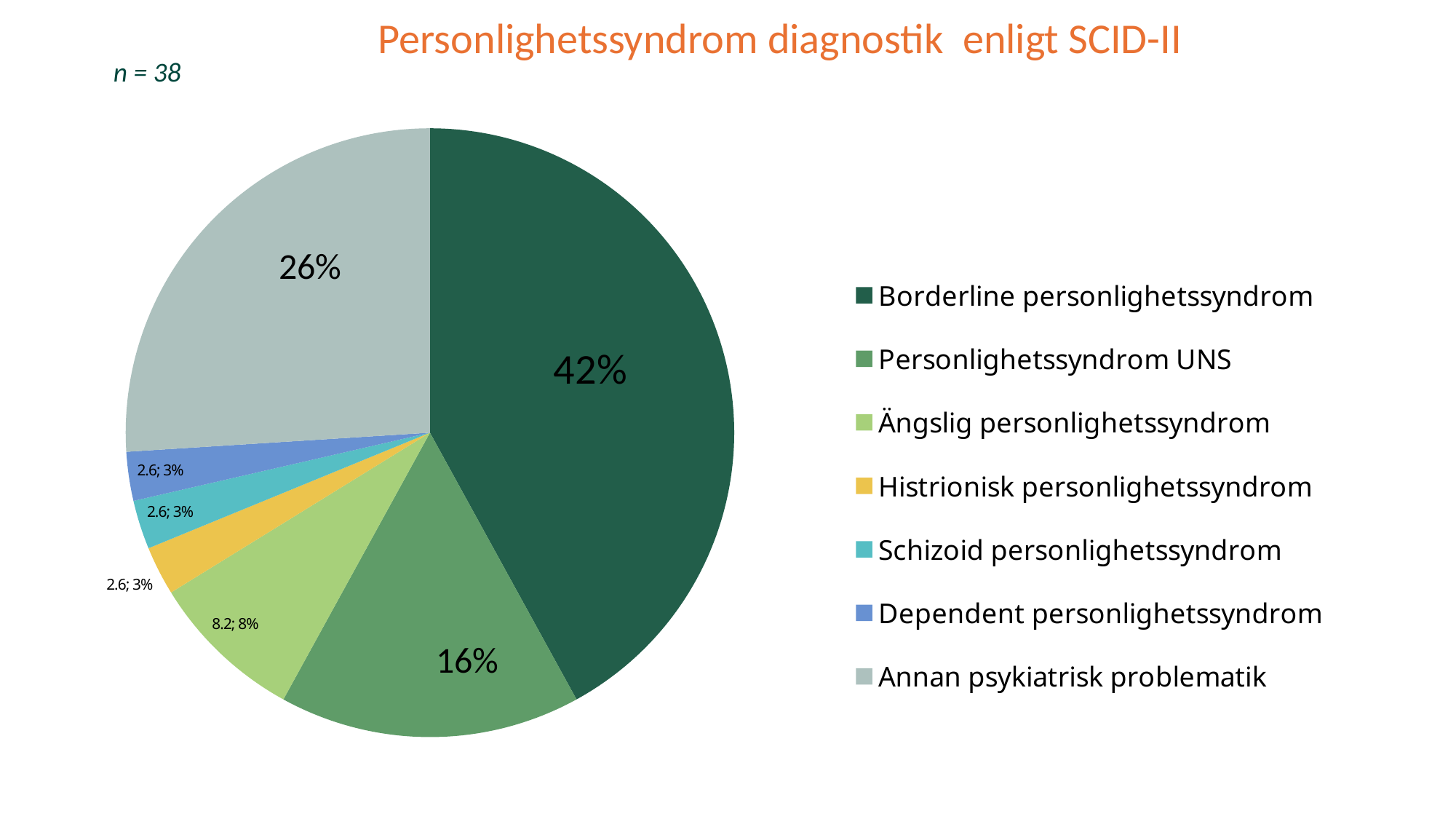
What percentage of the pie is Annan psykiatrisk problematik? 26% What is the title of the chart? Personlighetssyndrom diagnostik enligt SCID-II What sample size (n) is stated on the slide? n = 38 What type of chart is shown on the slide? pie chart What percentage of the pie is Borderline personlighetssyndrom? 42% What percentage of the pie is Ängslig personlighetssyndrom? 8% What is the difference in percentage points between the Borderline personlighetssyndrom slice and the Annan psykiatrisk problematik slice? 16 How many categories does the legend list? 7 Which is larger, the slice for Annan psykiatrisk problematik or the slice for Personlighetssyndrom UNS? Annan psykiatrisk problematik What value is printed for the Histrionisk personlighetssyndrom slice? 2.6; 3% Which category has the largest slice of the pie? Borderline personlighetssyndrom